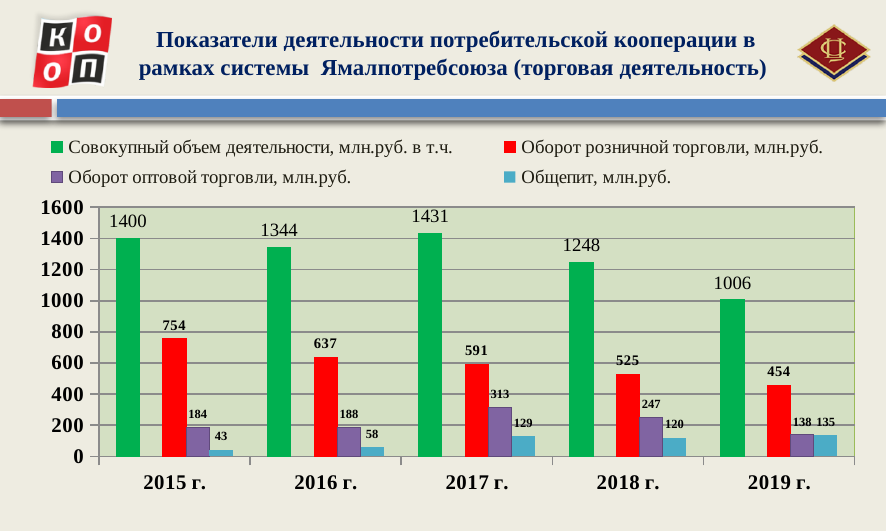
In which year is Совокупный объем деятельности the highest? 2017 г. What kind of chart is shown on the slide? Bar chart What is the value of Оборот оптовой торговли for 2018 г.? 247 In which year is Общепит the lowest? 2015 г. What is the value of Оборот розничной торговли for 2015 г.? 754 How many years are shown on the x axis? 5 What is the value of Общепит for 2019 г.? 135 How many series does the legend list? 4 Does Оборот розничной торговли rise or fall from 2015 г. to 2019 г.? Fall What is the difference between Оборот розничной торговли in 2015 г. and 2019 г.? 300 What is the value of Совокупный объем деятельности for 2017 г.? 1431 Which is larger in 2017 г.: Оборот оптовой торговли or Общепит? Оборот оптовой торговли